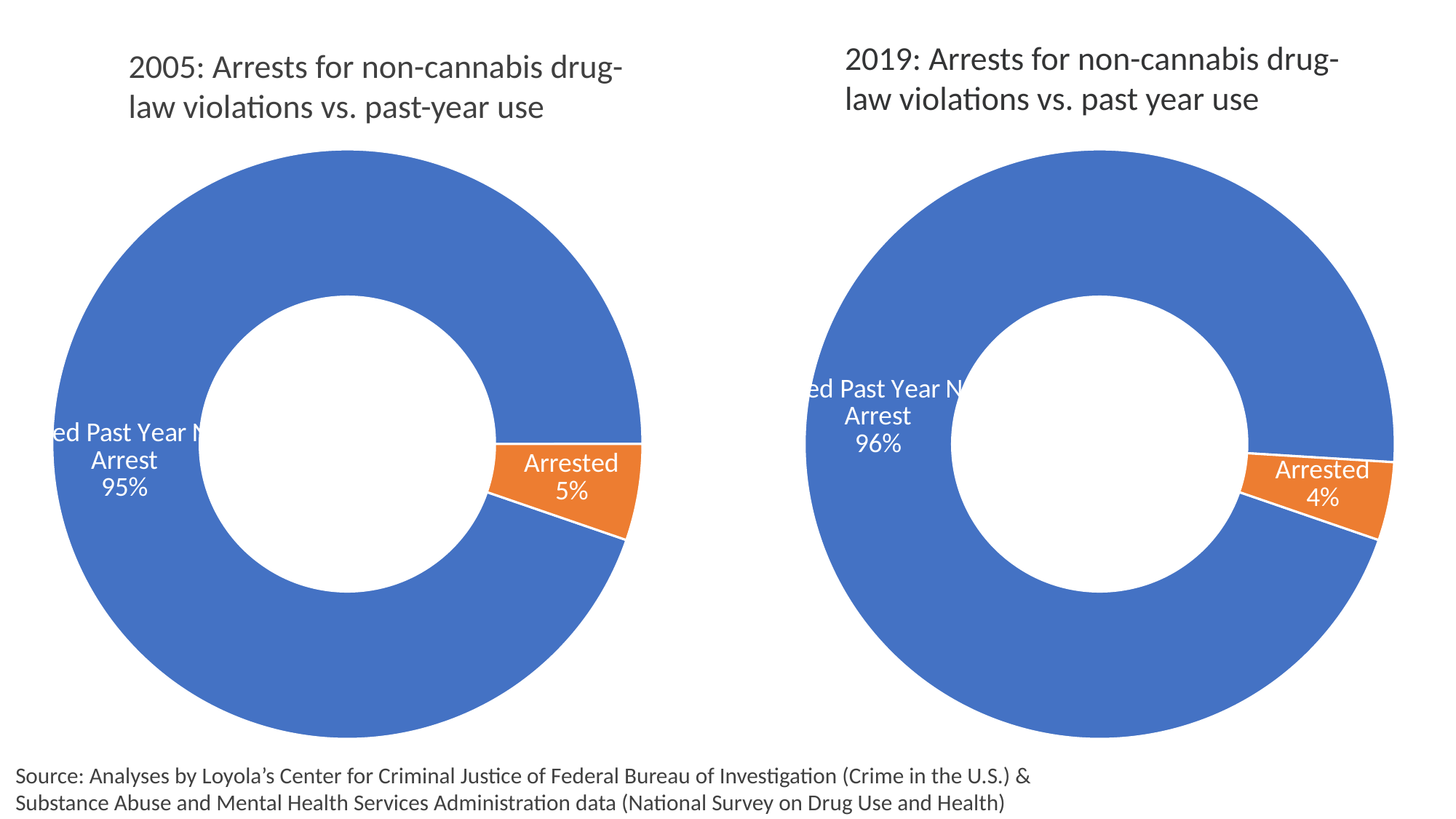
What is the title of the chart on the right? 2019: Arrests for non-cannabis drug-law violations vs. past year use In the 2005 chart, which slice is the smallest? Arrested In the 2005 chart, what percentage is shown on the large blue slice? 95% Is the "Arrested" share larger in the 2005 chart or the 2019 chart? 2005 In the 2019 chart, what percentage is shown on the large blue slice? 96% What colour is the "Arrested" slice in both charts? Orange In the 2005 chart, what share of the donut is labelled "Arrested"? 5% In the 2019 chart, what is the difference between the blue slice's share and the "Arrested" share? 92 percentage points In the 2019 chart, what share of the donut is labelled "Arrested"? 4% What is the difference between the "Arrested" share in the 2005 chart and in the 2019 chart? 1 percentage point How many slices does the 2019 chart on the right have? 2 What kind of chart is the 2005 chart on the left? Donut (pie) chart